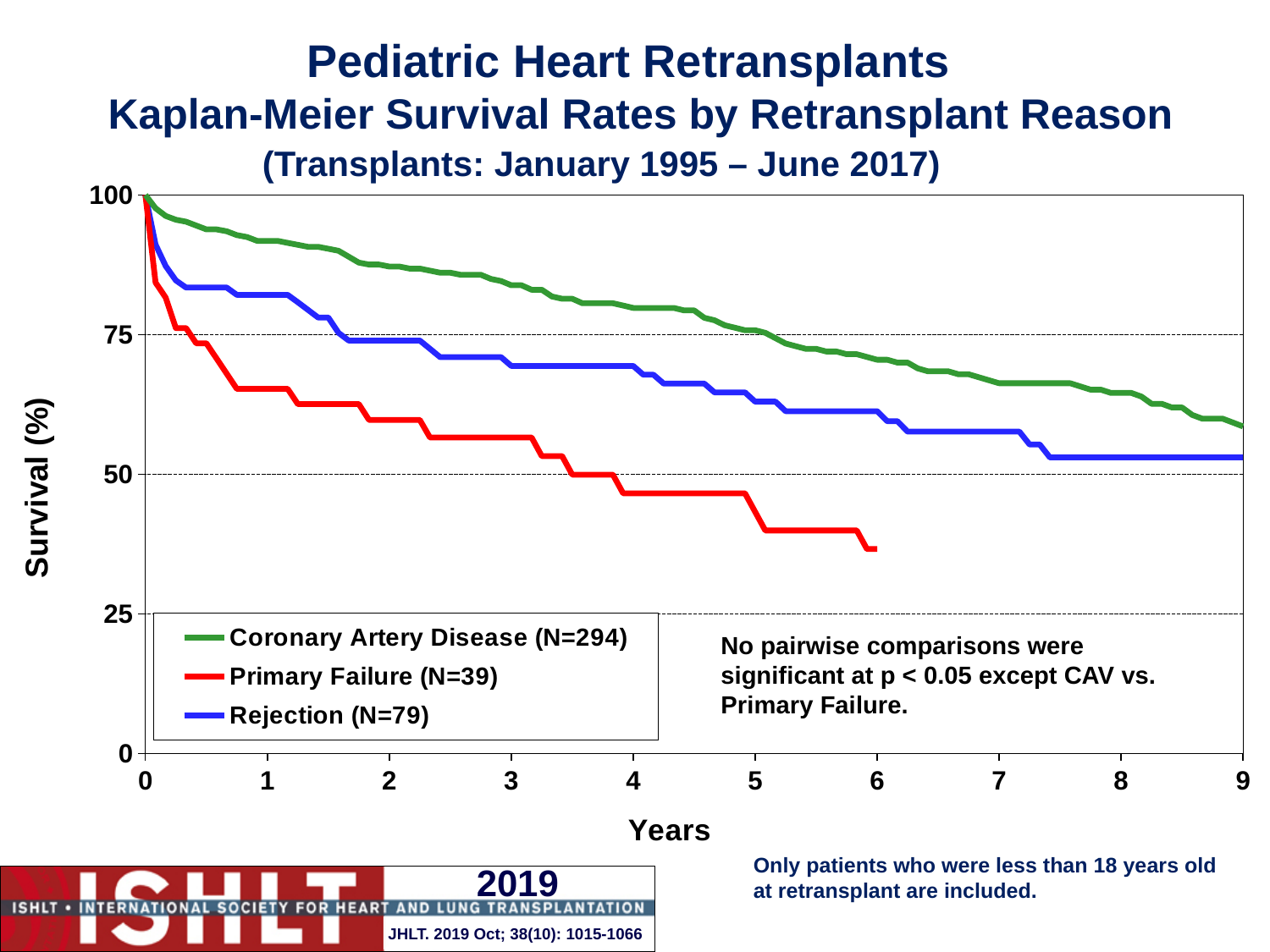
Is the survival for Coronary Artery Disease at 3 years greater or less than 75? greater Which group has the lowest survival at 4 years? Primary Failure Is the survival for Coronary Artery Disease at 9 years greater or less than 50? greater What kind of chart is shown on the slide? Line chart How many series does the legend list? 3 At 4 years, which group has higher survival: Coronary Artery Disease or Primary Failure? Coronary Artery Disease What is the N shown in the legend for the Primary Failure group? N=39 Is the survival for Rejection at 8 years greater or less than 75? less Which group has the highest survival at 6 years? Coronary Artery Disease What is the survival (%) for all three groups at year 0? 100 Do the survival curves rise or fall as years increase? fall